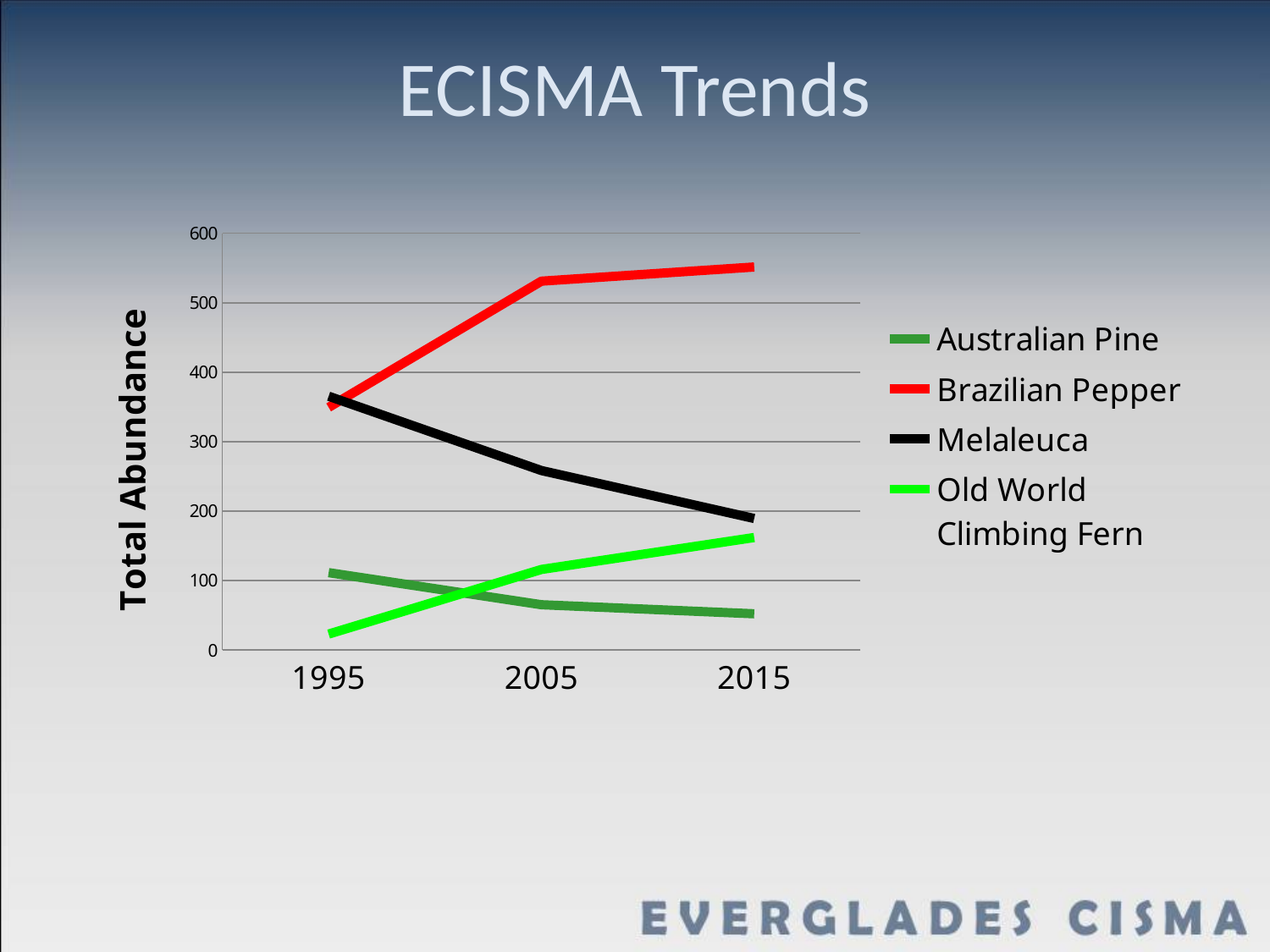
Is the value for Melaleuca in 2015 greater or less than 300? less Does the Brazilian Pepper line rise or fall from 1995 to 2015? rise In 2005, which is larger: Old World Climbing Fern or Australian Pine? Old World Climbing Fern How many years are plotted along the x axis? 3 Does the Melaleuca line rise or fall from 1995 to 2015? fall How many series does the legend list? 4 Is the value for Brazilian Pepper in 2015 greater or less than 500? greater Which species has the highest total abundance in 2015? Brazilian Pepper Does the Australian Pine line rise or fall from 1995 to 2015? fall What kind of chart is shown on the slide? line chart Which species has the lowest total abundance in 1995? Old World Climbing Fern